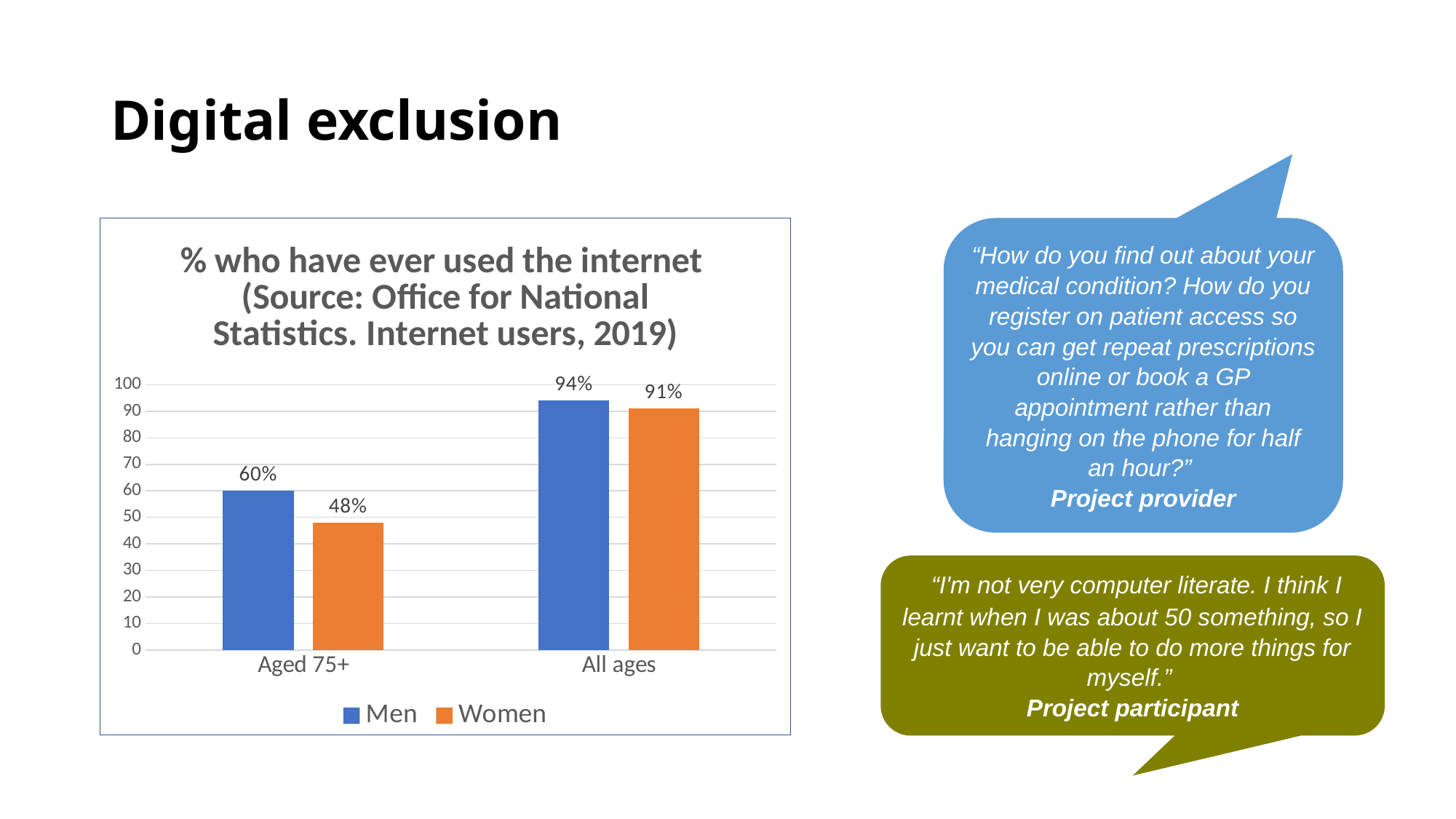
Which bar has the highest value in the chart? Men, All ages What percentage of women aged 75+ have ever used the internet? 48% What is the difference between the Men values for All ages and Aged 75+? 34% Which bar has the lowest value in the chart? Women, Aged 75+ What is the difference between the Men and Women values for Aged 75+? 12% How many categories are shown on the x axis? 2 What kind of chart is shown on the slide? Bar chart What is the value for Women in the All ages category? 91% Which is larger for All ages: the value for Men or for Women? Men What percentage of men aged 75+ have ever used the internet? 60% How many series does the legend list? 2 What is the value for Men in the All ages category? 94%